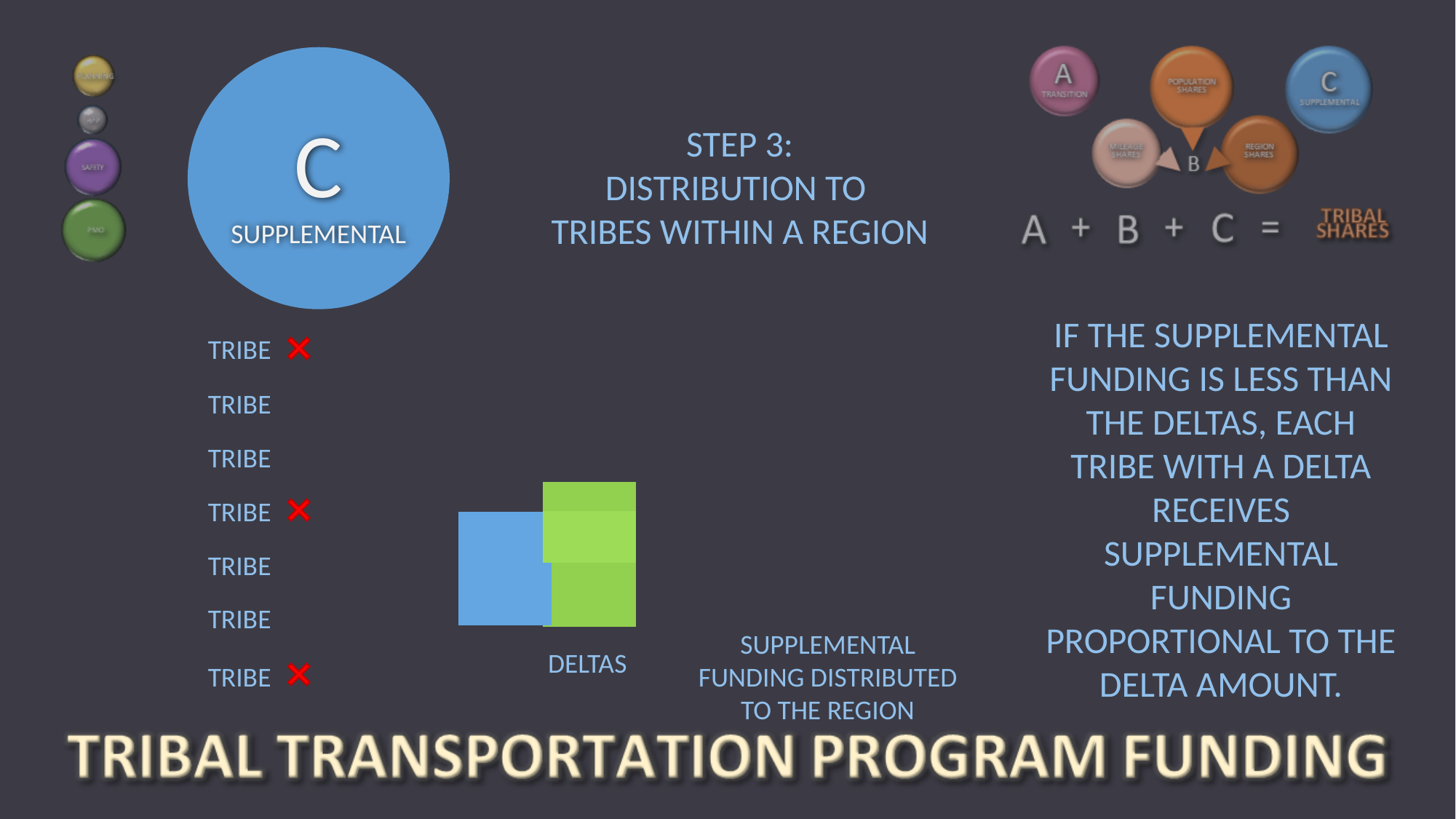
How many TRIBE entries are listed in the left column of the slide? 7 What colour is the block labelled as the supplemental funding distributed to the region? blue What label appears beneath the blue and green blocks in the middle of the slide? DELTAS How many of the TRIBE entries are marked with a red X? 3 How many green segments are stacked next to the blue block in the middle diagram? 2 Which block in the middle diagram is taller, the blue block or the green stacked block? the green stacked block